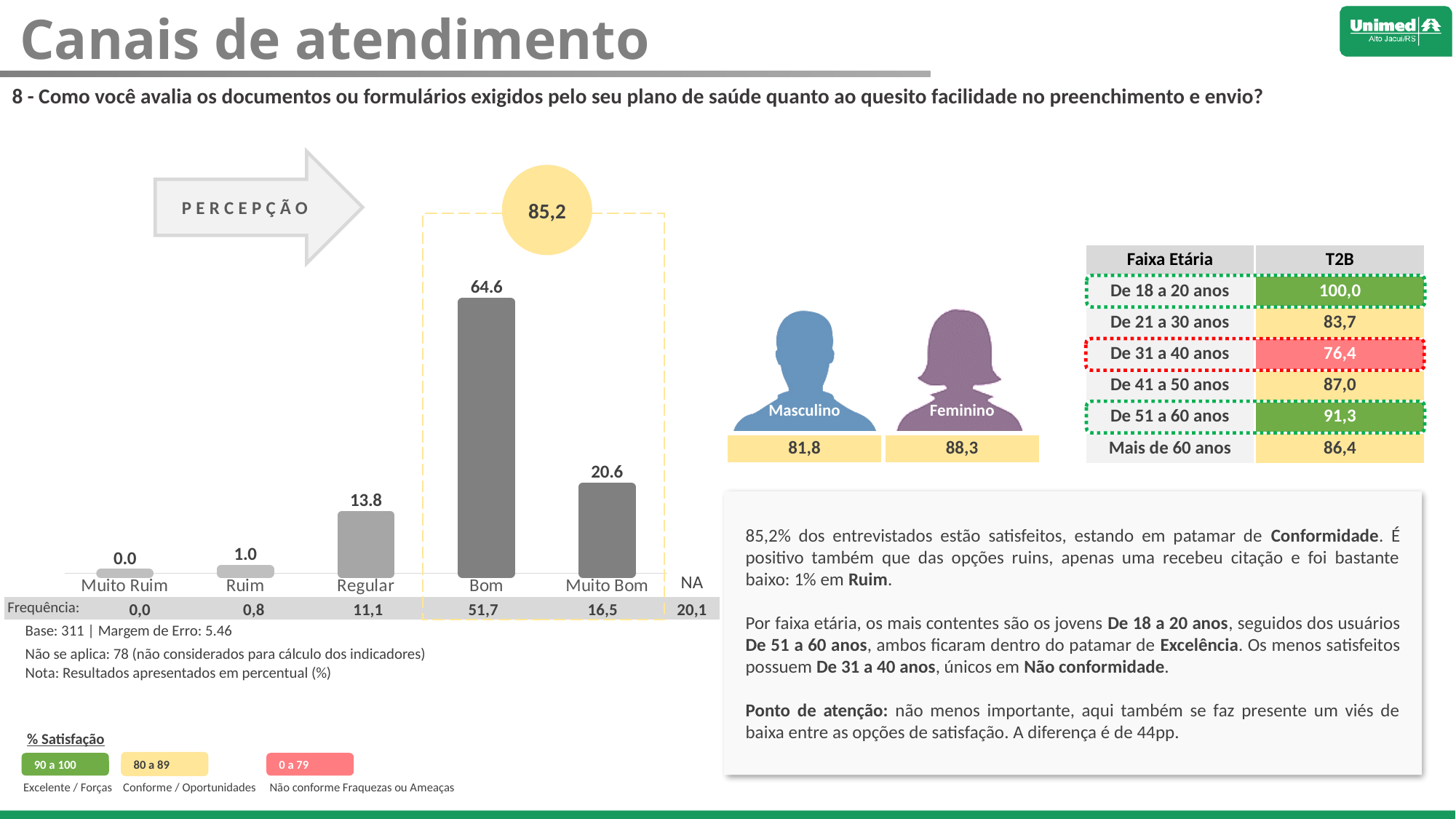
What is the value for Muito Bom in the bar chart? 20.6 Do the values rise or fall along the x axis from Muito Ruim to Bom? rise What is the difference between the values for Bom and Muito Bom? 44.0 What kind of chart is shown on the slide? bar chart What is the value for Ruim in the bar chart? 1.0 What value is shown in the yellow circle above the highlighted Bom and Muito Bom bars? 85,2 What is the difference between the values for Regular and Ruim? 12.8 Which category has the highest value in the bar chart? Bom What is the value for Bom in the bar chart? 64.6 Which is larger, the value for Regular or the value for Muito Bom? Muito Bom What is the value for Regular in the bar chart? 13.8 Which category has the lowest value in the bar chart? Muito Ruim